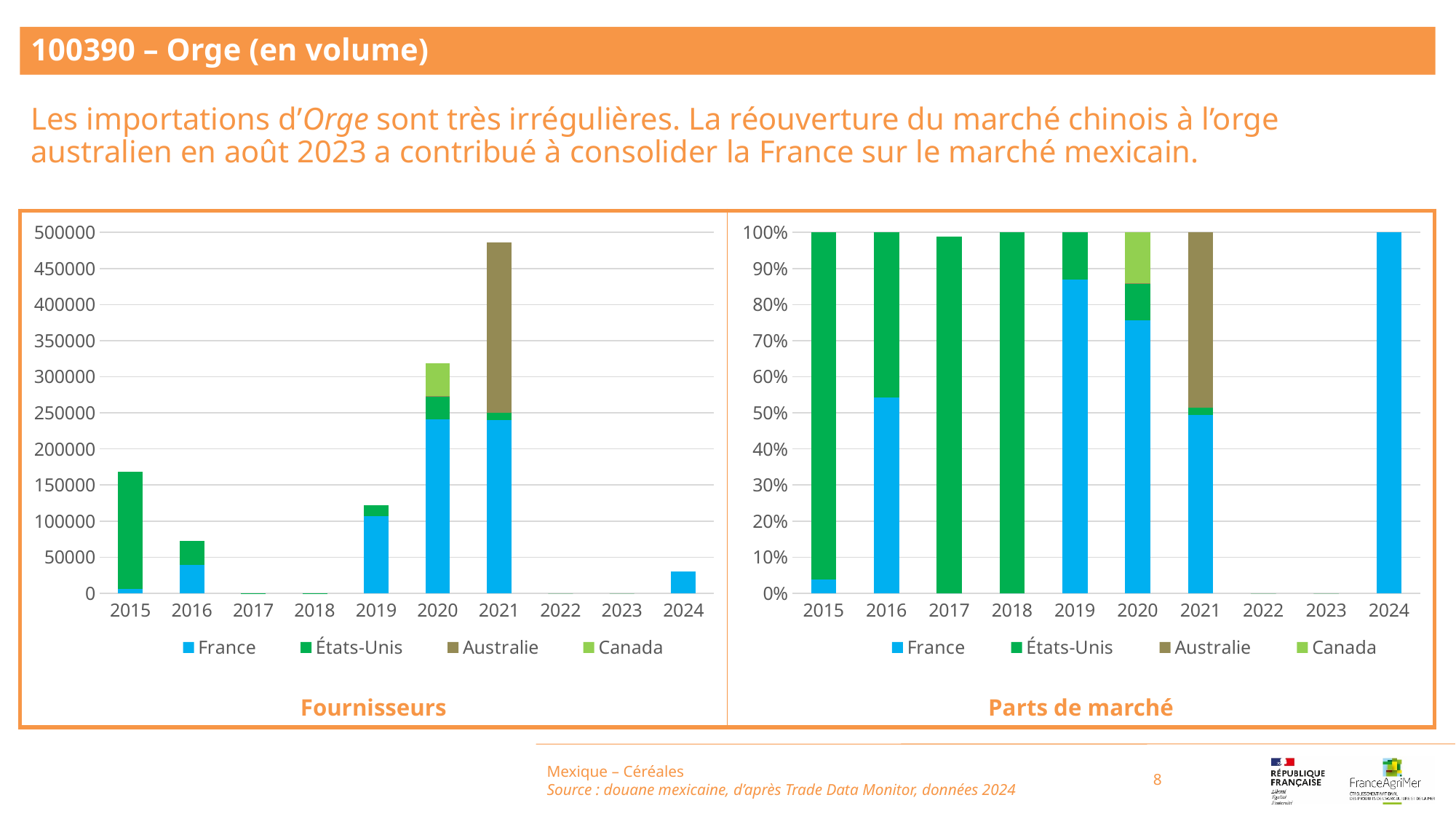
What kind of chart is the Fournisseurs chart? bar chart In the Parts de marché chart, is the share of France in 2016 greater or less than 50%? greater In the Parts de marché chart, is the share of France in 2019 greater or less than 80%? greater In the Fournisseurs chart, is the total bar for 2020 greater or less than 300000? greater Which colour represents Australie in the legend of the Fournisseurs chart? brown In the Fournisseurs chart, which total bar is larger, 2015 or 2016? 2015 In the Fournisseurs chart, which year has the highest total bar? 2021 How many years are shown on the x axis of the Fournisseurs chart? 10 How many series does the legend of the Parts de marché chart list? 4 In the Parts de marché chart, what is the share of France in 2024? 100%